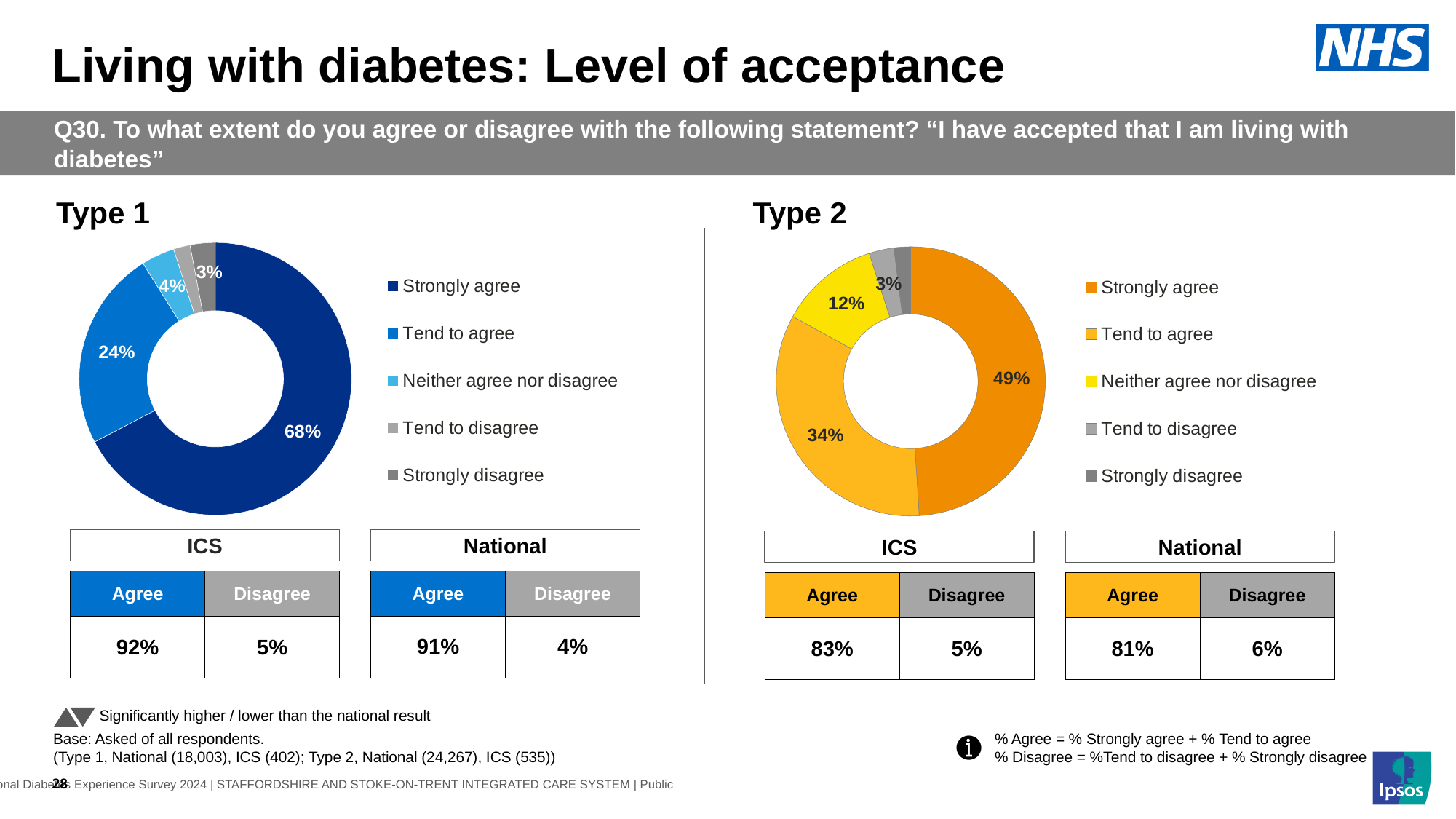
In the Type 2 chart, what percentage of respondents tend to agree? 34% In the Type 1 chart, which response category has the largest share? Strongly agree In the Type 2 chart, which response category has the largest share? Strongly agree What is the difference between the Strongly agree share in the Type 1 chart and the Strongly agree share in the Type 2 chart? 19 percentage points In the Type 1 chart, which is larger: Tend to agree or Neither agree nor disagree? Tend to agree In the Type 2 chart, what percentage neither agree nor disagree? 12% In the Type 1 chart, what percentage of respondents strongly agree? 68% In the Type 1 chart, what colour represents Strongly agree? Dark blue How many response categories does the legend of the Type 2 chart list? 5 What kind of chart is used to show the Type 1 results? Donut (pie) chart In the Type 2 chart, what colour represents Neither agree nor disagree? Yellow In the Type 1 chart, what percentage neither agree nor disagree? 4%